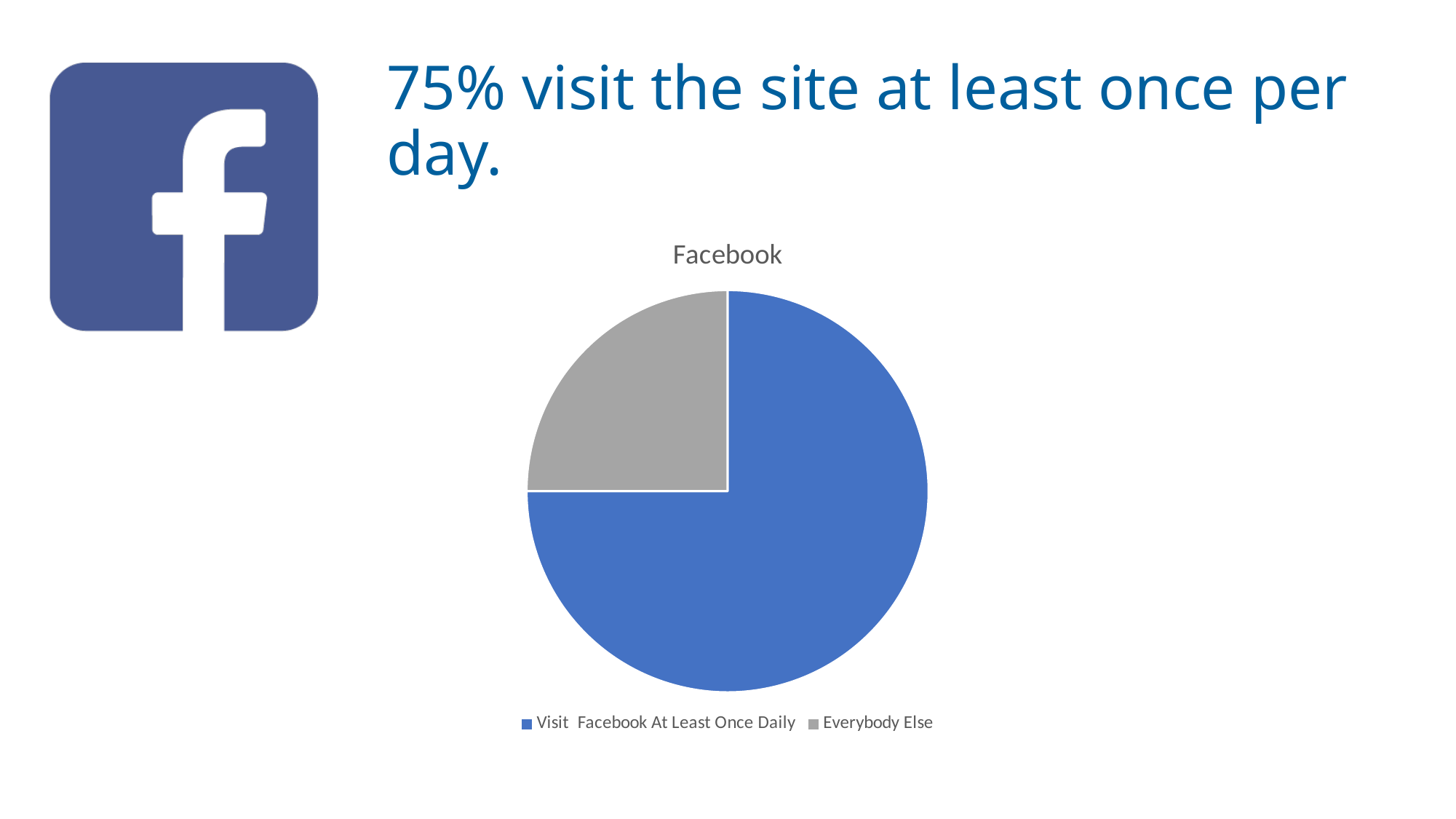
What colour is the 'Everybody Else' slice in the pie chart? gray Which slice of the pie chart is the largest? Visit Facebook At Least Once Daily Which slice is larger: 'Visit Facebook At Least Once Daily' or 'Everybody Else'? Visit Facebook At Least Once Daily What kind of chart is shown on the slide? pie chart How many entries does the legend of the pie chart list? 2 According to the slide, what share of the pie does 'Visit Facebook At Least Once Daily' represent? 75% What is the title of the pie chart? Facebook How many slices does the pie chart have? 2 Which slice of the pie chart is the smallest? Everybody Else